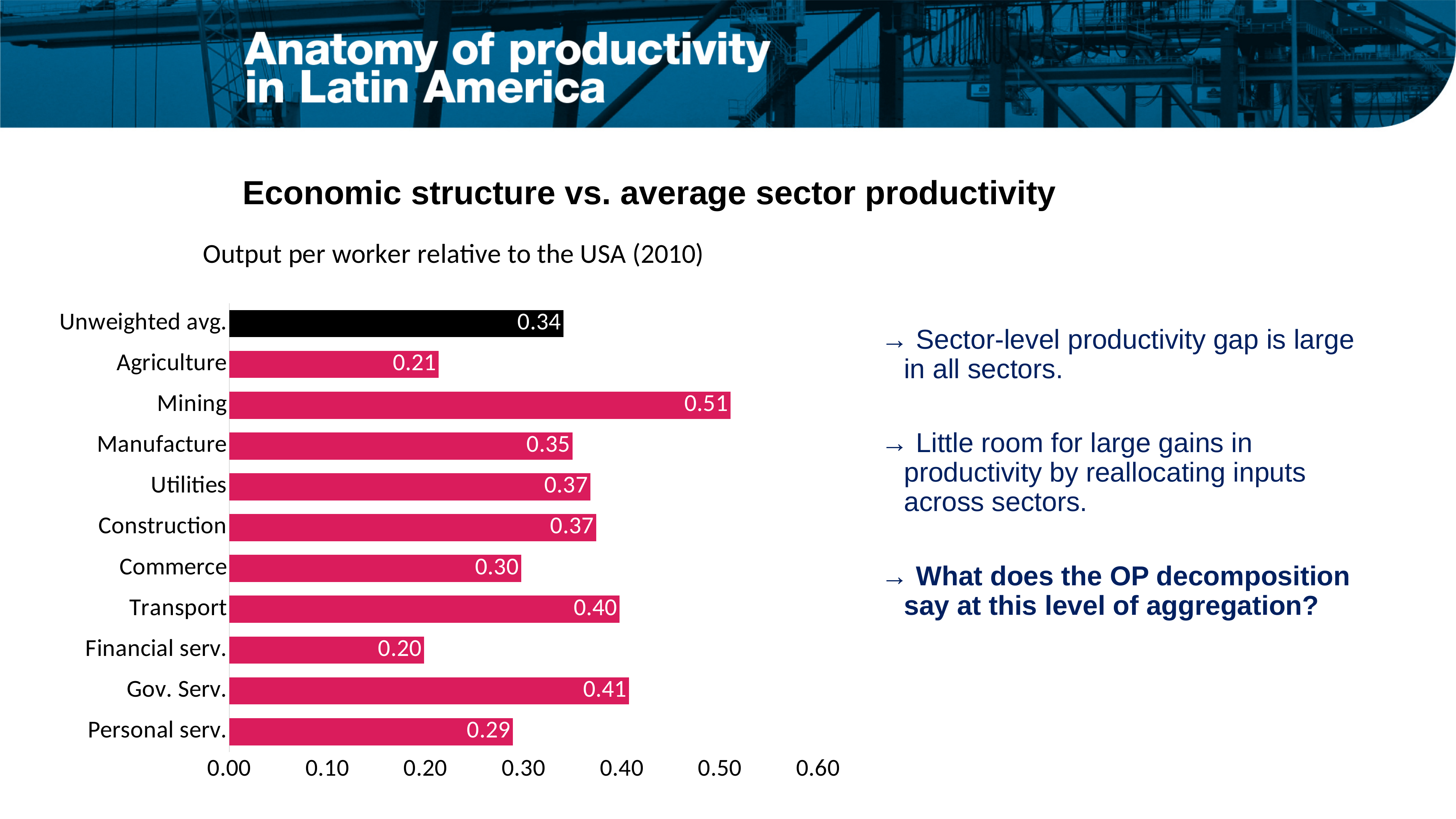
What is the difference between the values for Mining and Agriculture? 0.30 Which sector has the highest output per worker relative to the USA? Mining Which sector has the lowest output per worker relative to the USA? Financial serv. What is the value for Mining? 0.51 What is the value for the Unweighted avg. bar? 0.34 What kind of chart is shown on the slide? Bar chart Which is larger, the value for Transport or the value for Commerce? Transport What is the title of the chart? Output per worker relative to the USA (2010) What is the value for Gov. Serv.? 0.41 How many bars are shown in the chart? 11 What is the value for Financial serv.? 0.20 Is the value for Personal serv. greater or less than 0.30? less